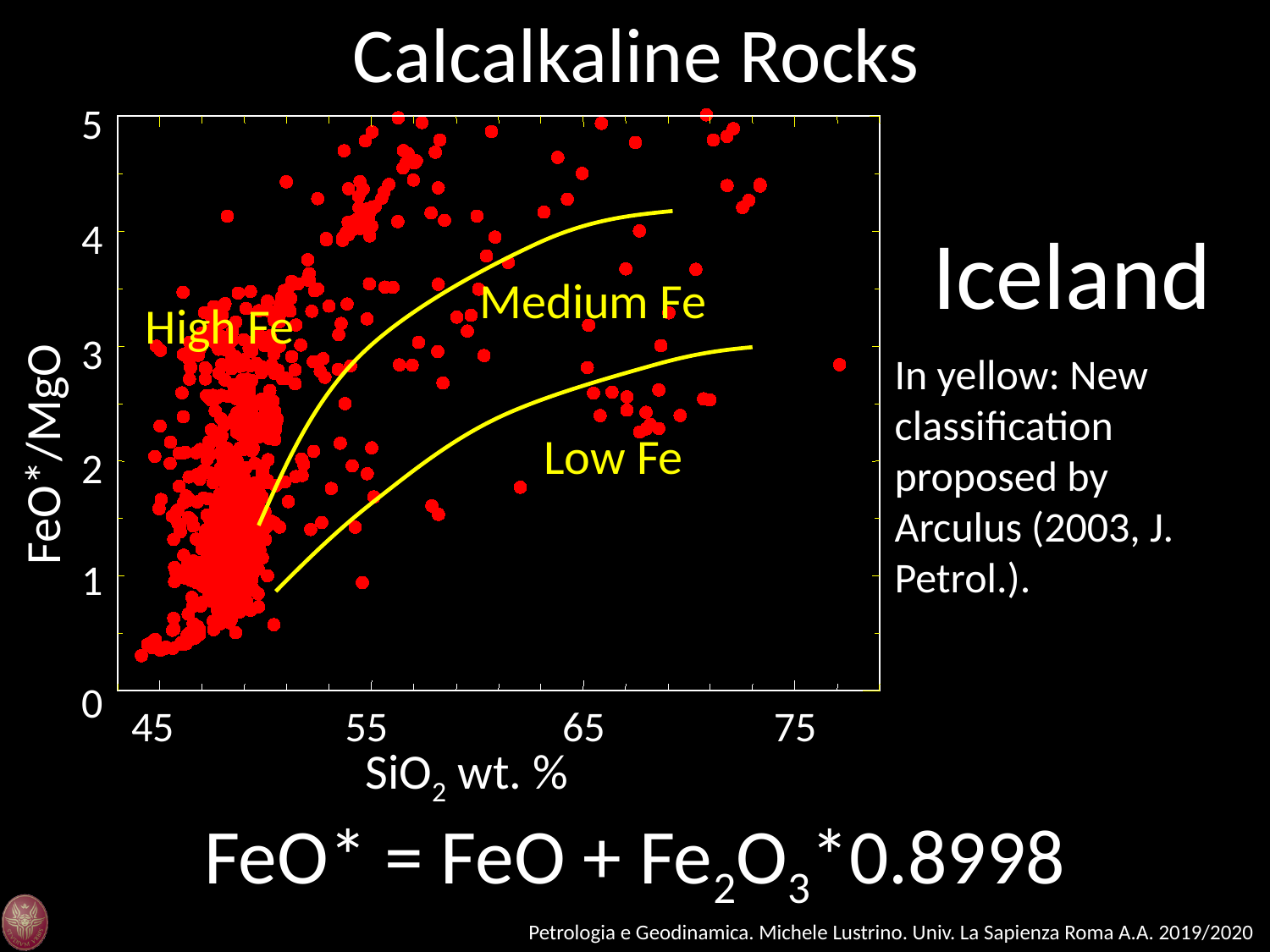
What quantity is plotted on the y axis of the chart? FeO*/MgO What kind of chart is shown on the slide? Scatter plot How many yellow boundary curves are drawn on the chart? 2 What is the highest SiO2 wt. % tick label shown on the x axis? 75 Is the FeO*/MgO value of the isolated red point at the far right of the chart (near SiO2 = 77 wt. %) greater or less than 2? greater Which labelled field lies below the lower yellow curve? Low Fe What is the highest value shown on the y axis (FeO*/MgO)? 5 Is the SiO2 wt. % of the densest cluster of red points greater or less than 55? less What is the title of the chart? Calcalkaline Rocks As SiO2 wt. % increases, do the yellow boundary curves rise or fall? Rise How many compositional fields (High Fe, Medium Fe, Low Fe) are labelled on the chart? 3 Is the FeO*/MgO value of the lowest red point on the chart greater or less than 1? less